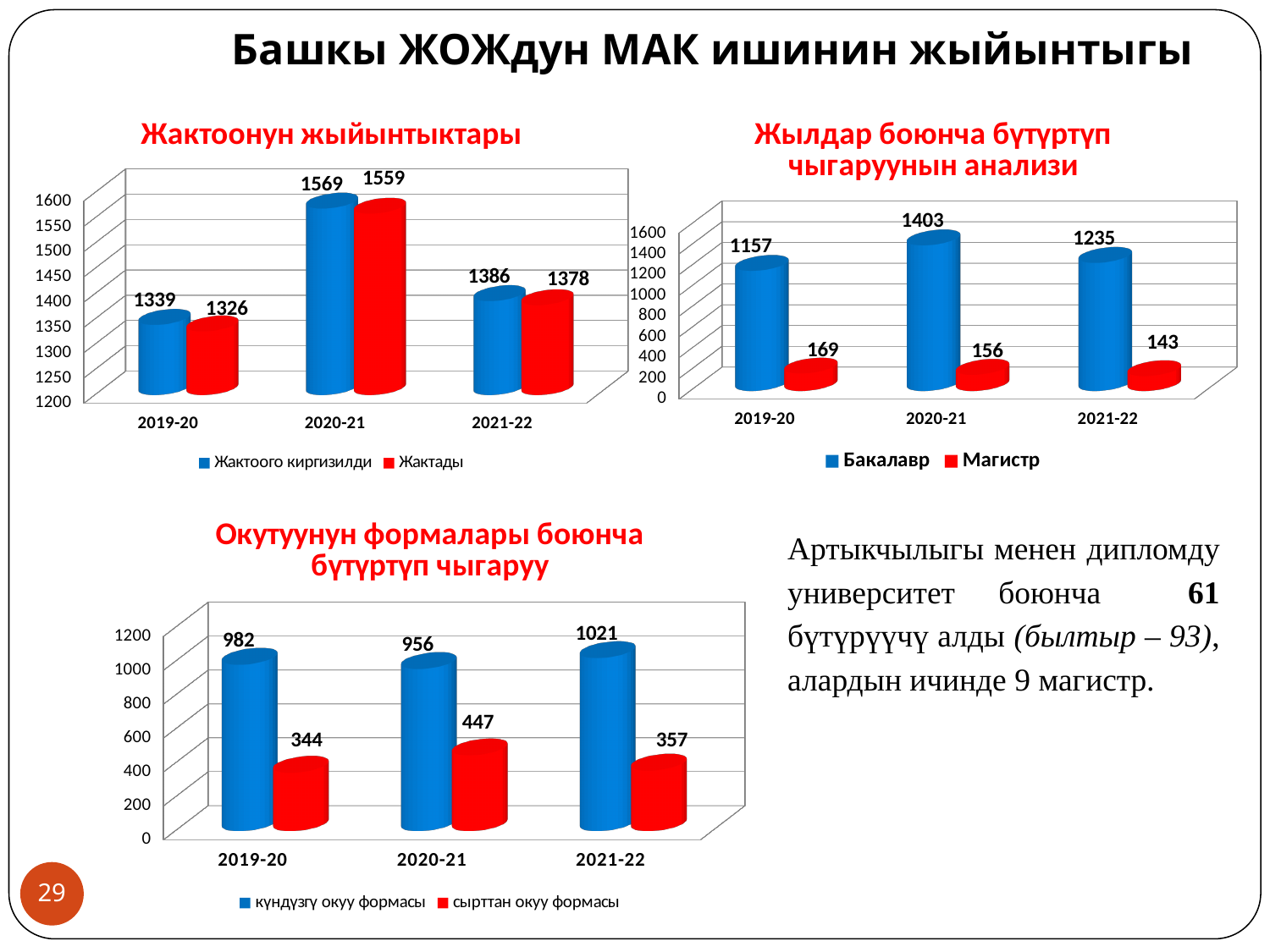
In the chart titled "Окутуунун формалары боюнча бүтүртүп чыгаруу", what is the value for "сырттан окуу формасы" in 2020-21? 447 In the chart titled "Жактоонун жыйынтыктары", which year has the highest value for "Жактады"? 2020-21 In the chart titled "Окутуунун формалары боюнча бүтүртүп чыгаруу", which year has the highest value for "күндүзгү окуу формасы"? 2021-22 What kind of chart is the one titled "Окутуунун формалары боюнча бүтүртүп чыгаруу"? bar chart In the chart titled "Жылдар боюнча бүтүртүп чыгаруунын анализи", what is the value for "Магистр" in 2020-21? 156 In the chart titled "Жактоонун жыйынтыктары", what is the value for "Жактады" in 2021-22? 1378 In the chart titled "Жылдар боюнча бүтүртүп чыгаруунын анализи", how many series does the legend list? 2 In the chart titled "Жактоонун жыйынтыктары", what is the difference between "Жактоого киргизилди" and "Жактады" in 2019-20? 13 In the chart titled "Жылдар боюнча бүтүртүп чыгаруунын анализи", do the "Магистр" values rise or fall from 2019-20 to 2021-22? fall In the chart titled "Жылдар боюнча бүтүртүп чыгаруунын анализи", which year has the lowest value for "Бакалавр"? 2019-20 In the chart titled "Жактоонун жыйынтыктары", what is the value for "Жактоого киргизилди" in 2020-21? 1569 In the chart titled "Окутуунун формалары боюнча бүтүртүп чыгаруу", what is the difference between "күндүзгү окуу формасы" and "сырттан окуу формасы" in 2021-22? 664